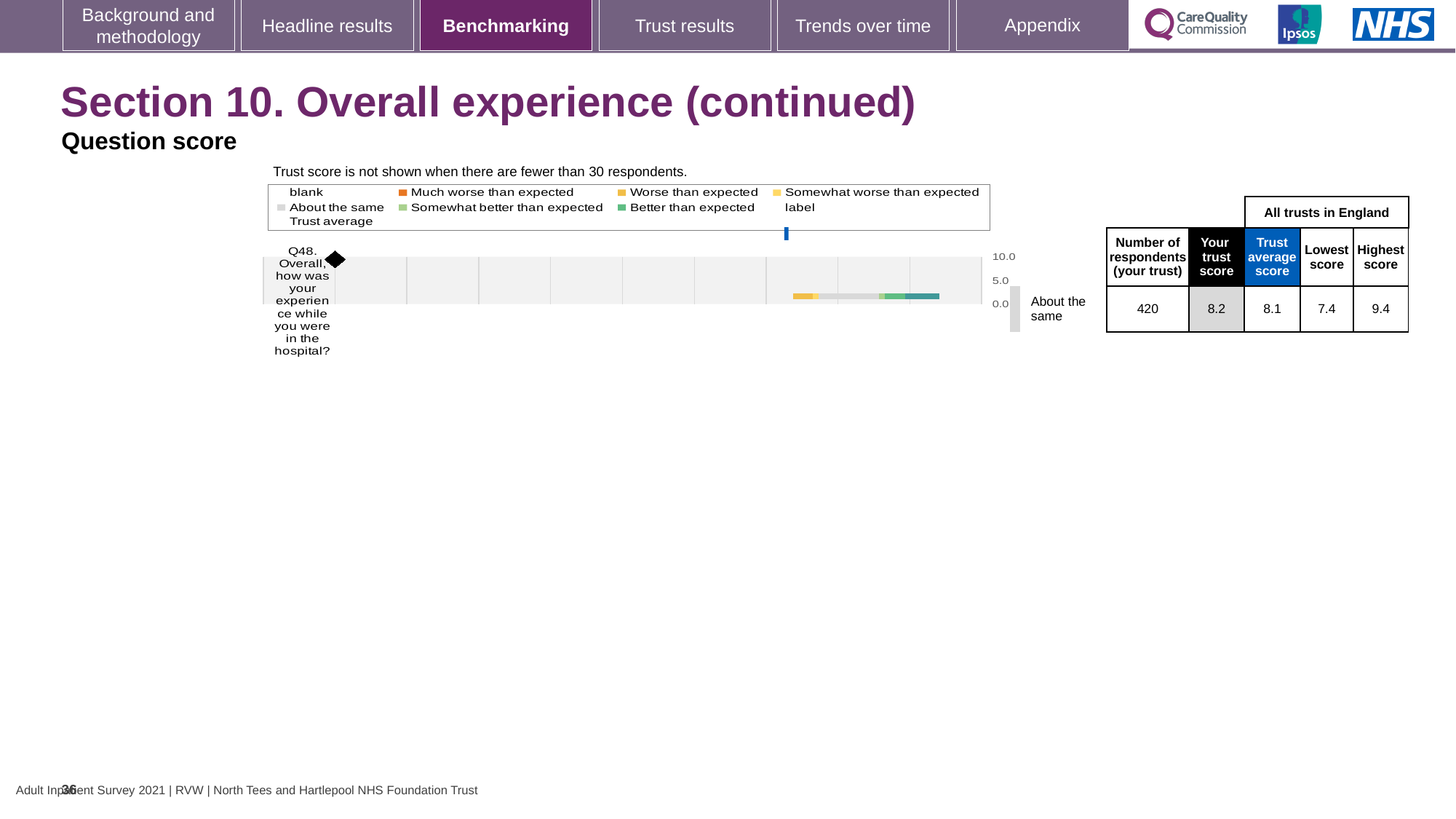
What benchmark category is shown beside the chart for Q48? About the same Which question is plotted on the chart? Q48. Overall, how was your experience while you were in the hospital? In the table next to the chart, what is your trust score for Q48? 8.2 What kind of chart is shown on the slide? bar chart In the table next to the chart, what is the number of respondents for your trust for Q48? 420 In the table next to the chart, what is the lowest score among all trusts in England for Q48? 7.4 In the table next to the chart, what is the difference between the highest score and the lowest score for Q48? 2.0 In the table next to the chart, what is the highest score among all trusts in England for Q48? 9.4 In the table next to the chart, what is the trust average score for Q48? 8.1 How many survey questions are plotted on the chart? 1 What is the highest value shown on the chart's axis? 10.0